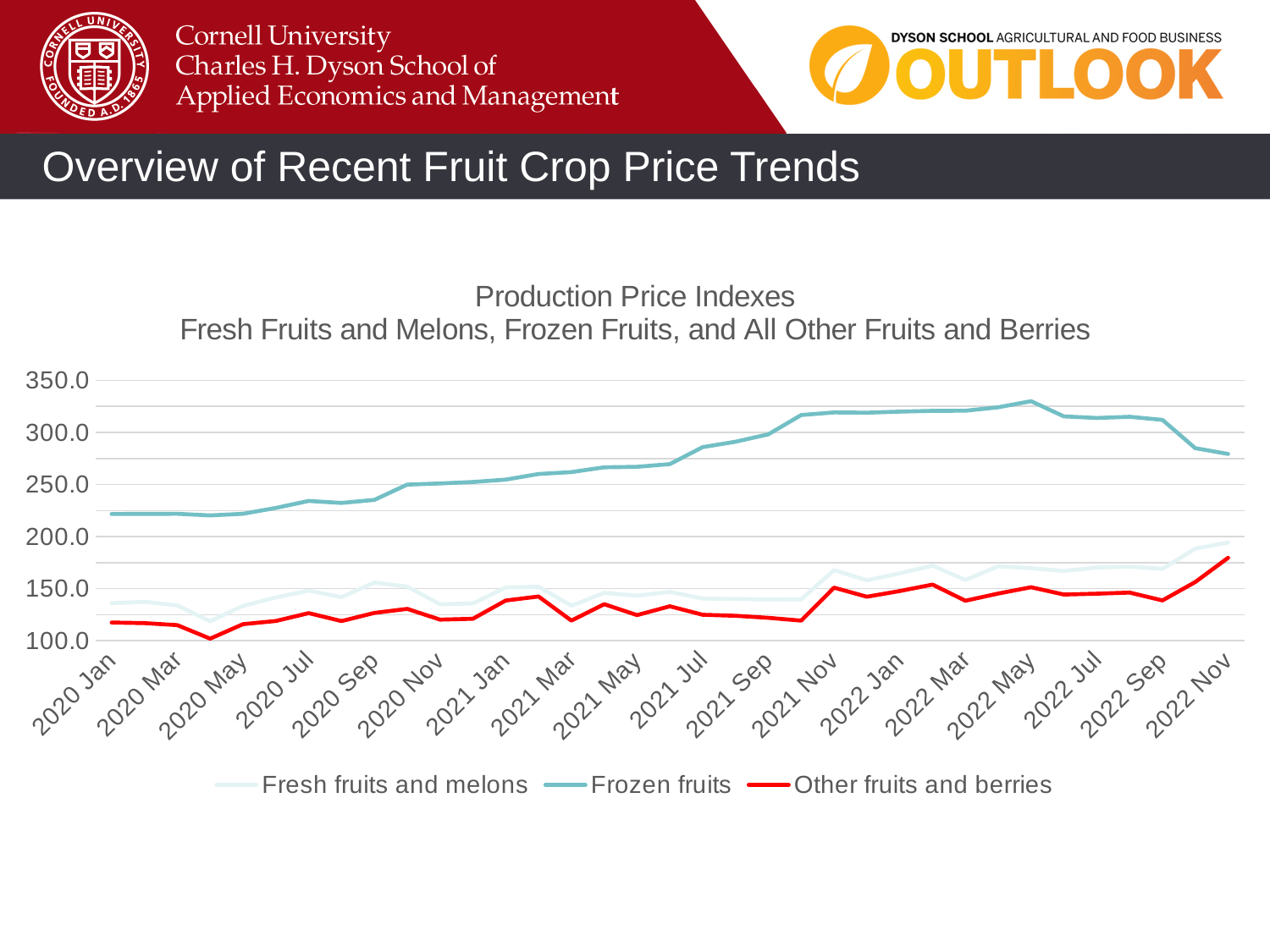
Is the value for Other fruits and berries in 2022 Nov greater or less than 150? greater Is the value for Frozen fruits in 2022 May greater or less than 300? greater Is the value for Frozen fruits in 2022 Nov greater or less than 300? less Does the Frozen fruits series rise or fall from 2020 Jan to 2022 May? Rise How many series does the legend list? 3 Which series has the highest values across the whole period? Frozen fruits In 2021 Jan, which is larger: Frozen fruits or Other fruits and berries? Frozen fruits What is the title of the chart? Production Price Indexes Fresh Fruits and Melons, Frozen Fruits, and All Other Fruits and Berries What kind of chart is shown on the slide? Line chart Which series has the lowest values for most of the period? Other fruits and berries Which series is drawn in red? Other fruits and berries